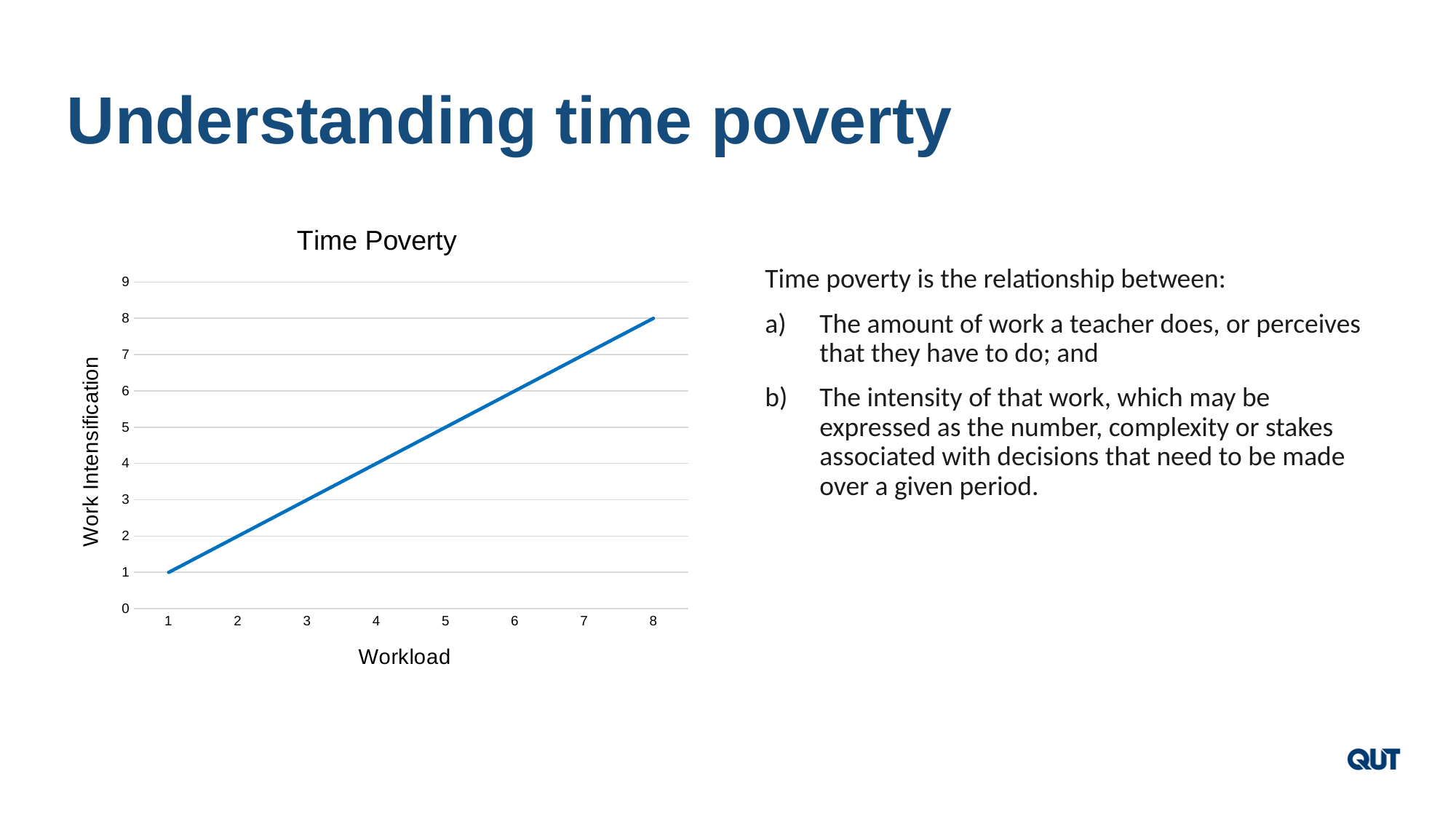
What kind of chart is shown on the slide? line chart What is the difference in Work Intensification between Workload 8 and Workload 1? 7 What is the Work Intensification value when Workload is 4? 4 At which Workload value is Work Intensification highest? 8 Does Work Intensification rise or fall as Workload increases along the x axis? rise At which Workload value is Work Intensification lowest? 1 What is the Work Intensification value when Workload is 8? 8 Is the Work Intensification value at Workload 7 greater or less than 5? greater What is the Work Intensification value when Workload is 1? 1 What is the label on the x axis of the chart? Workload How many Workload values are marked along the x axis? 8 What is the title of the chart? Time Poverty